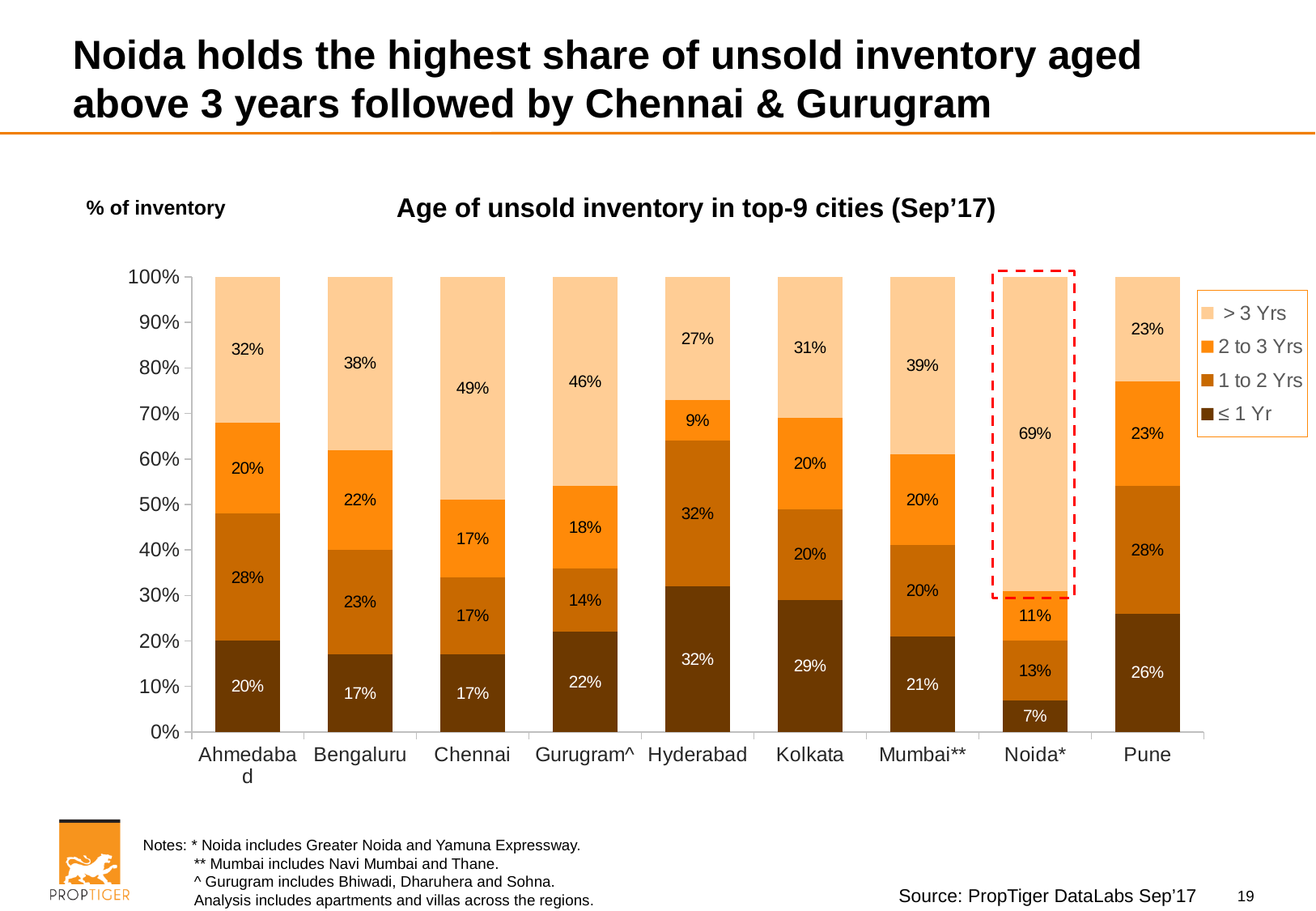
What is the 2 to 3 Yrs share for Bengaluru? 22% How many series does the legend list? 4 Which city has the lowest share of unsold inventory aged 1 year or less? Noida* Which city's bar is highlighted with a red dashed outline? Noida* What is the difference between the > 3 Yrs share for Chennai and for Gurugram^? 3% Which city has the lowest share of unsold inventory aged more than 3 years? Pune What share of unsold inventory in Noida* is aged more than 3 years? 69% How many cities are shown on the x axis? 9 What is the value for the ≤ 1 Yr segment for Hyderabad? 32% What kind of chart is shown on the slide? Stacked bar chart Which is larger: the > 3 Yrs share for Mumbai** or for Bengaluru? Mumbai** Which city has the highest share of unsold inventory aged more than 3 years? Noida*